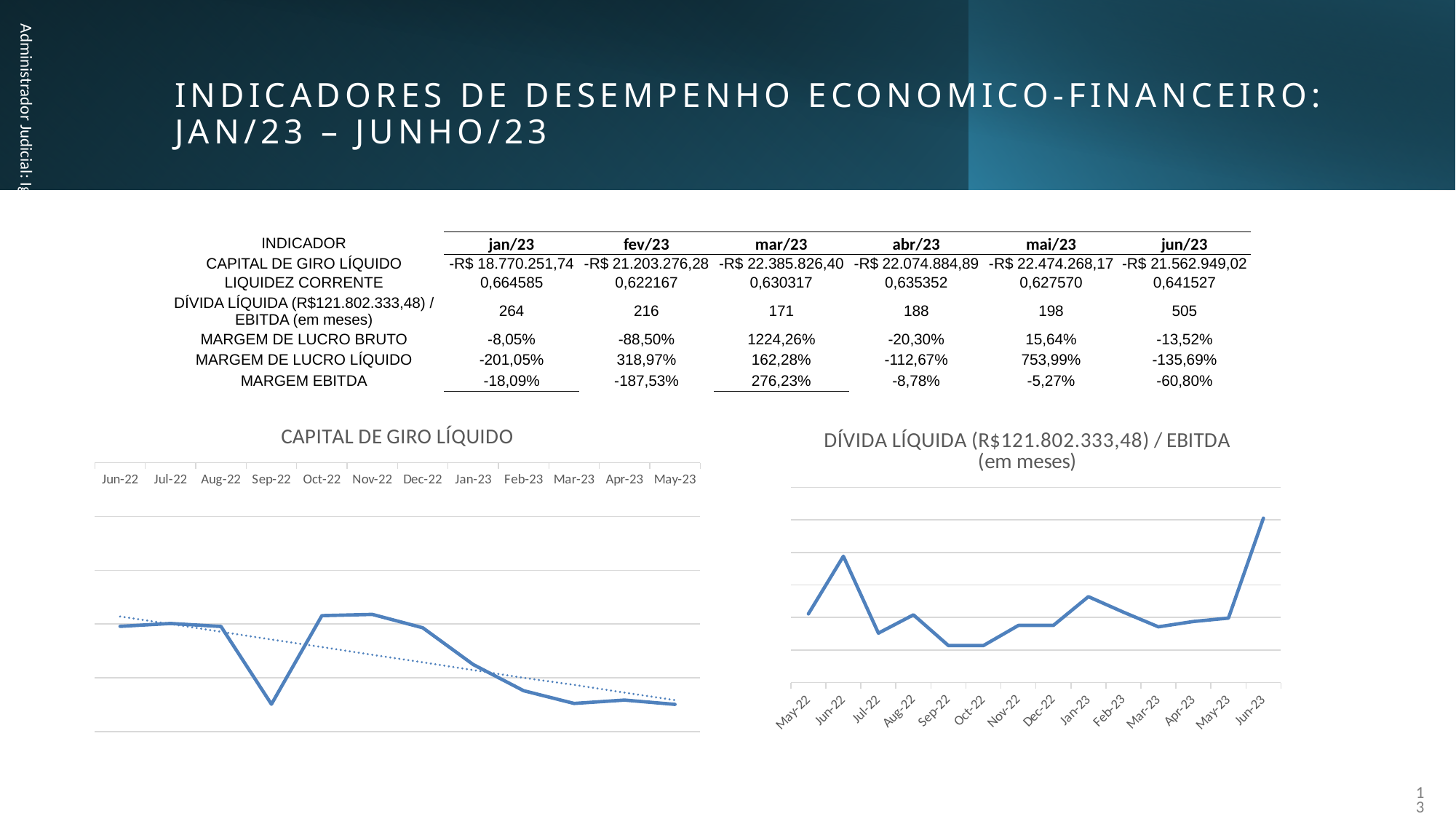
In the DÍVIDA LÍQUIDA / EBITDA chart on the right, which month has the highest value? Jun-23 What is the title of the chart on the left of the slide? CAPITAL DE GIRO LÍQUIDO What is the first month labelled on the x axis of the DÍVIDA LÍQUIDA / EBITDA chart on the right? May-22 How many months are labelled on the x axis of the CAPITAL DE GIRO LÍQUIDO chart on the left? 12 In the CAPITAL DE GIRO LÍQUIDO chart on the left, does the dotted trend line rise or fall from left to right? fall What kind of chart is the CAPITAL DE GIRO LÍQUIDO chart on the left? line chart What kind of chart is the DÍVIDA LÍQUIDA / EBITDA chart on the right? line chart In the DÍVIDA LÍQUIDA / EBITDA chart on the right, which is larger, the value for Jun-23 or for Jun-22? Jun-23 How many months are plotted on the x axis of the DÍVIDA LÍQUIDA / EBITDA chart on the right? 14 In the DÍVIDA LÍQUIDA / EBITDA chart on the right, which is larger, the value for Jan-23 or for Mar-23? Jan-23 In the DÍVIDA LÍQUIDA / EBITDA chart on the right, which is larger, the value for Jun-22 or for Jul-22? Jun-22